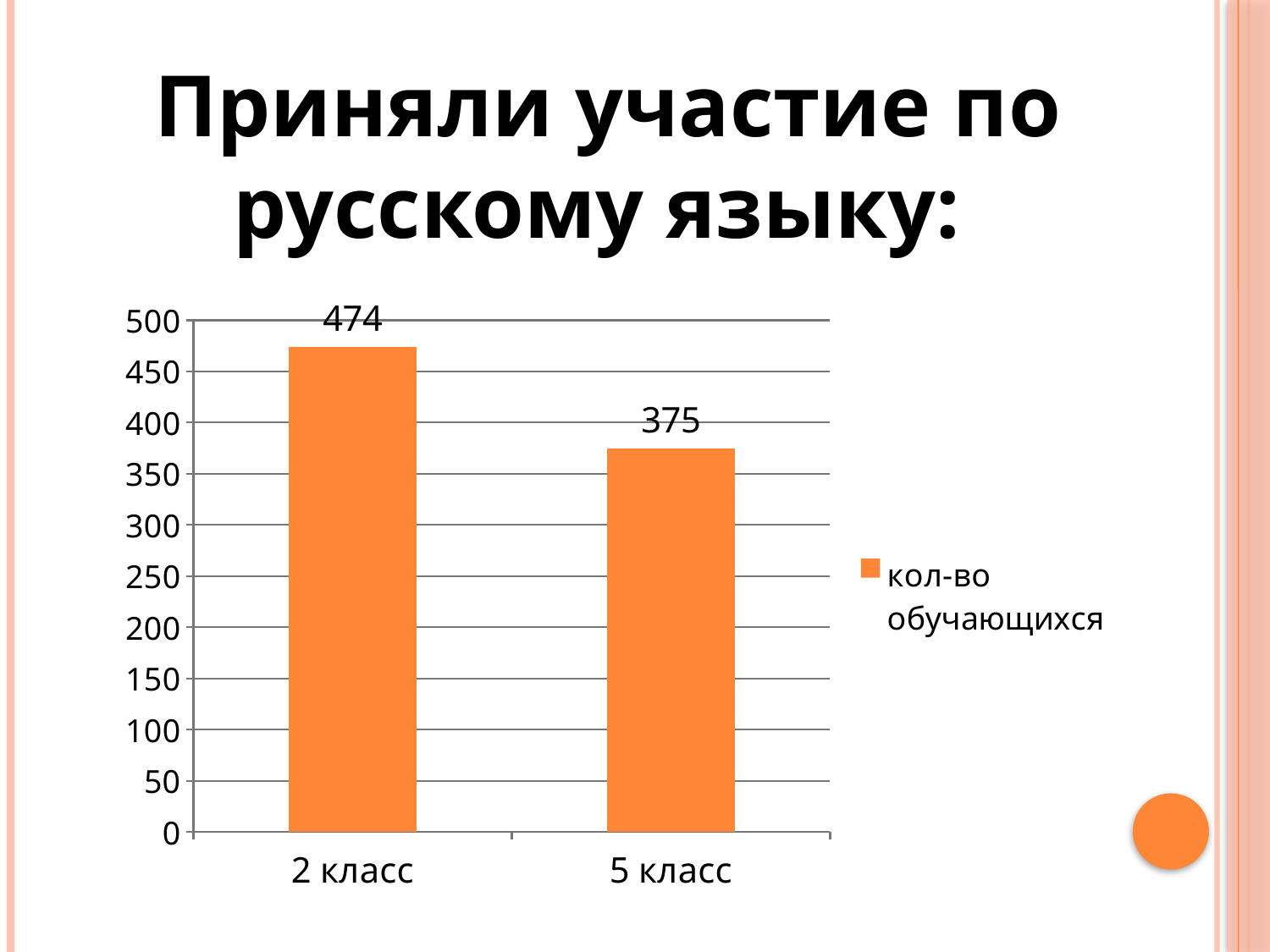
What is the value for 2 класс? 474 How many categories are shown on the x axis? 2 Is the value for 5 класс greater or less than 400? less Which category has the lowest value? 5 класс How many series does the legend list? 1 What is the legend entry for the series shown? кол-во обучающихся Is the value for 2 класс greater or less than 450? greater What is the difference between the values for 2 класс and 5 класс? 99 What kind of chart is shown on the slide? bar chart What is the value for 5 класс? 375 Which is larger, the value for 2 класс or the value for 5 класс? 2 класс Which category has the highest value? 2 класс